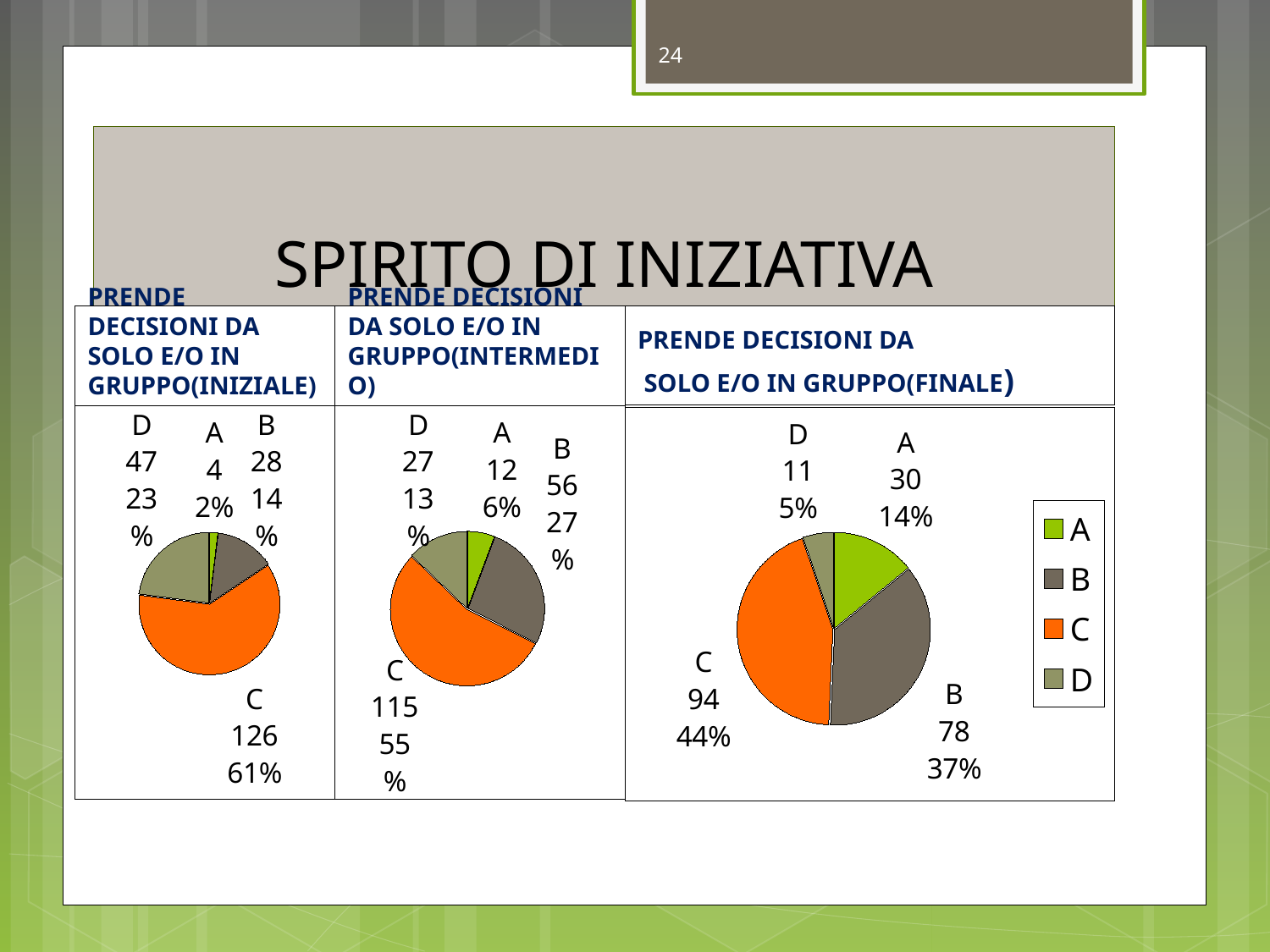
In the PRENDE DECISIONI DA SOLO E/O IN GRUPPO(FINALE) chart, what percentage share does category C have? 44% In the PRENDE DECISIONI DA SOLO E/O IN GRUPPO(INTERMEDIO) chart, which category has the smallest slice? A In the PRENDE DECISIONI DA SOLO E/O IN GRUPPO(INTERMEDIO) chart, what percentage share does category D have? 13% In the PRENDE DECISIONI DA SOLO E/O IN GRUPPO(INIZIALE) chart, which category has the largest slice? C In the PRENDE DECISIONI DA SOLO E/O IN GRUPPO(INIZIALE) chart, what percentage share does category A have? 2% In the PRENDE DECISIONI DA SOLO E/O IN GRUPPO(FINALE) chart, what is the difference between the values for C and B? 16 In the PRENDE DECISIONI DA SOLO E/O IN GRUPPO(FINALE) chart, what value is shown for category B? 78 In the PRENDE DECISIONI DA SOLO E/O IN GRUPPO(INTERMEDIO) chart, what value is shown for category B? 56 What kind of chart is used in the PRENDE DECISIONI DA SOLO E/O IN GRUPPO(FINALE) panel? Pie chart How many entries does the legend on the right of the slide list? 4 In the PRENDE DECISIONI DA SOLO E/O IN GRUPPO(FINALE) chart, which is larger, the value for A or the value for D? A In the PRENDE DECISIONI DA SOLO E/O IN GRUPPO(INIZIALE) chart, what value is shown for category C? 126